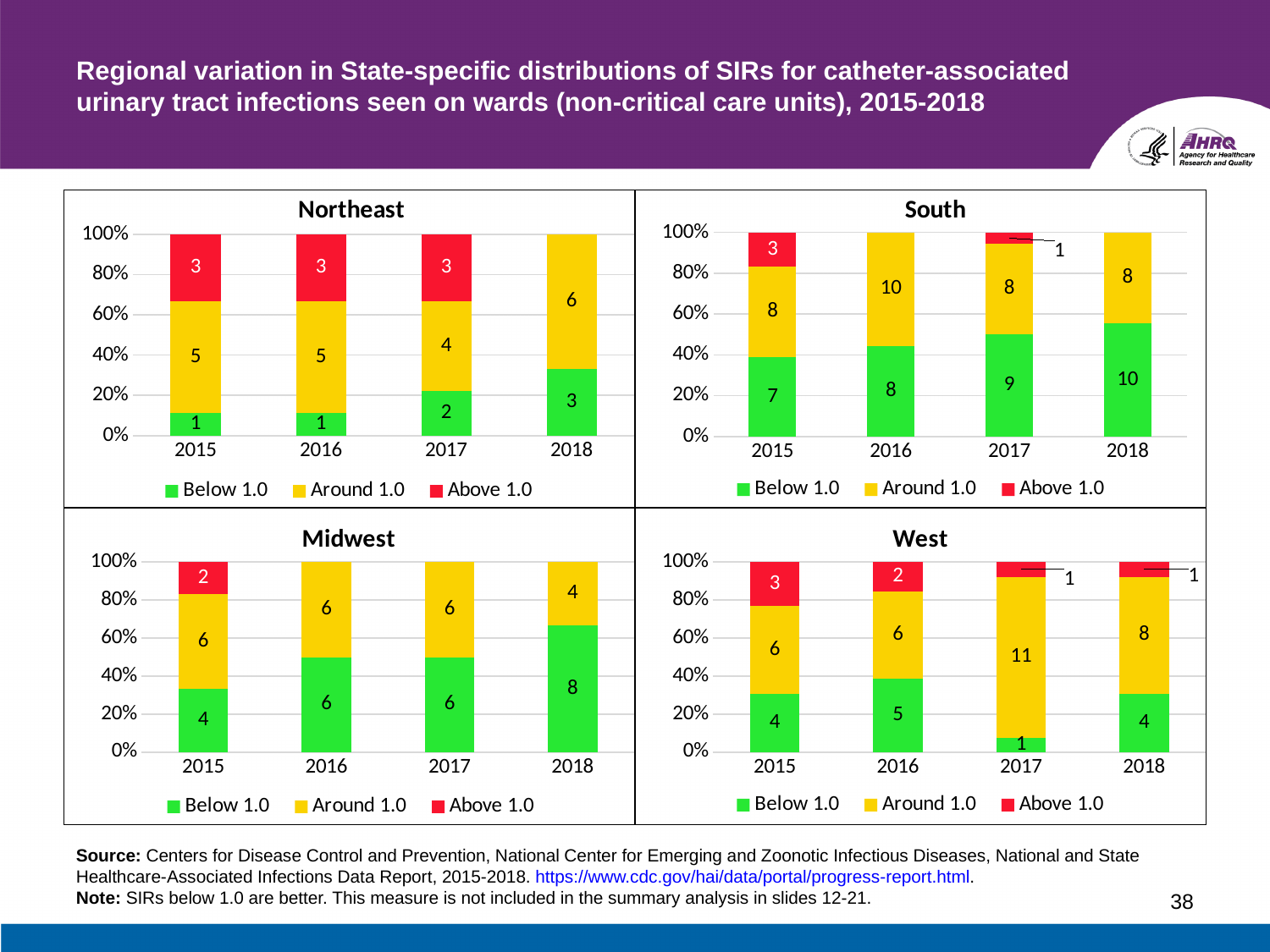
In the South chart, what is the total number of states represented in the 2015 bar? 18 In the Northeast chart, which is larger: the Around 1.0 value in 2018 or the Around 1.0 value in 2017? 2018 In the South chart, which year has the highest Below 1.0 value? 2018 In the West chart, what is the value for Around 1.0 in 2017? 11 How many series does the legend of the Midwest chart list? 3 In the West chart, what is the total number of states represented in the 2017 bar? 13 What type of chart is used for the Northeast panel? Stacked bar chart In the West chart, which year has the lowest Below 1.0 value? 2017 In the Northeast chart, how many states were in the Below 1.0 category in 2018? 3 In the South chart, what is the value for Around 1.0 in 2016? 10 In the Midwest chart, what is the difference between the Below 1.0 values for 2018 and 2015? 4 In the Midwest chart, what is the value for Above 1.0 in 2015? 2